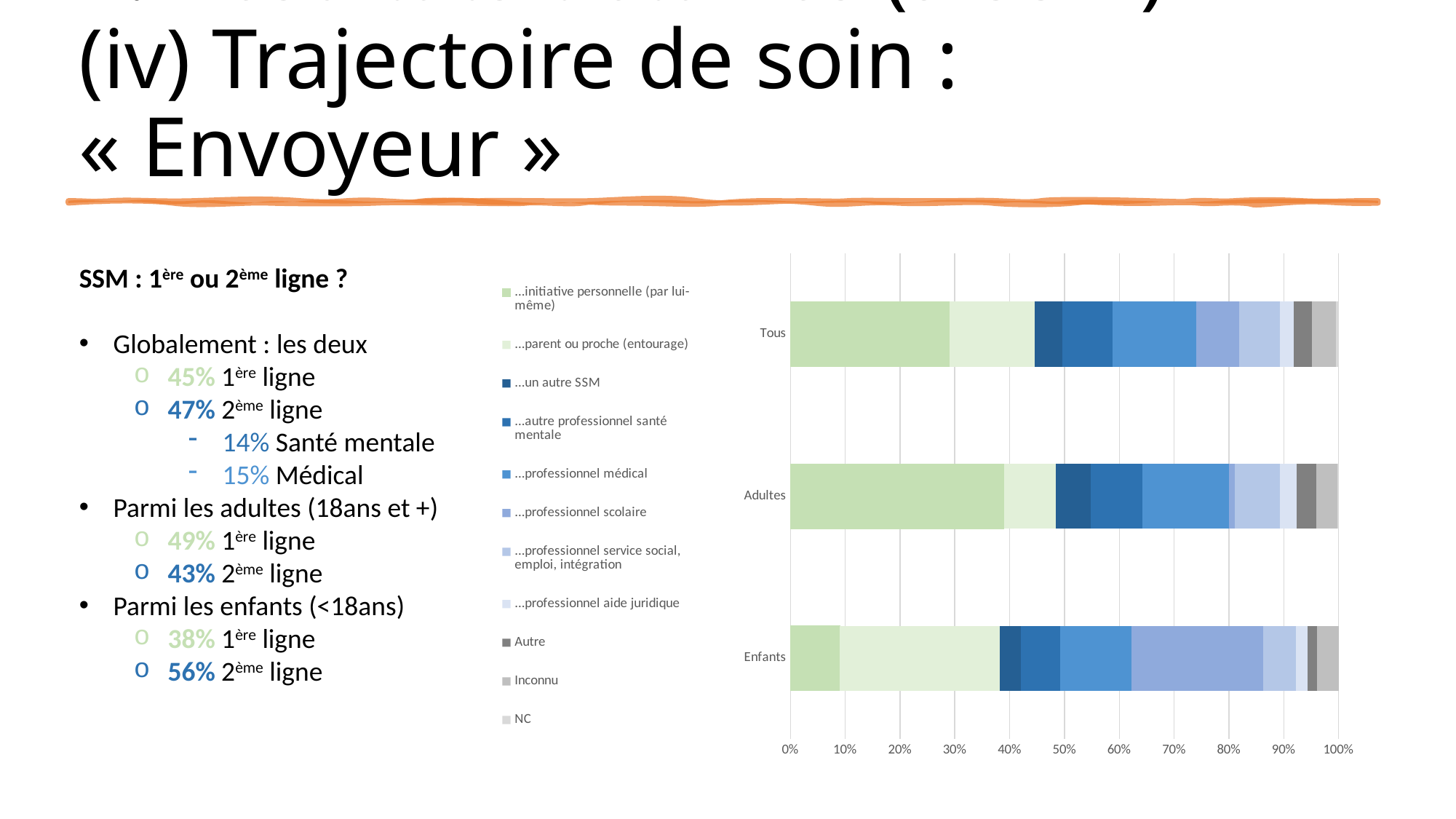
What kind of chart is shown on the right of the slide? stacked bar chart Is the '...initiative personnelle (par lui-même)' share for Tous greater or less than 20%? greater How many series does the chart legend list? 11 What are the three categories on the vertical axis of the chart? Tous, Adultes, Enfants What is the first entry in the chart legend? ...initiative personnelle (par lui-même) Which category has the largest '...initiative personnelle (par lui-même)' segment? Adultes Which has the larger '...professionnel scolaire' segment, Adultes or Enfants? Enfants Which has the larger '...parent ou proche (entourage)' segment, Adultes or Enfants? Enfants Which category has the smallest '...initiative personnelle (par lui-même)' segment? Enfants How many categories (bars) does the chart show? 3 Is the '...initiative personnelle (par lui-même)' share for Adultes greater or less than 30%? greater